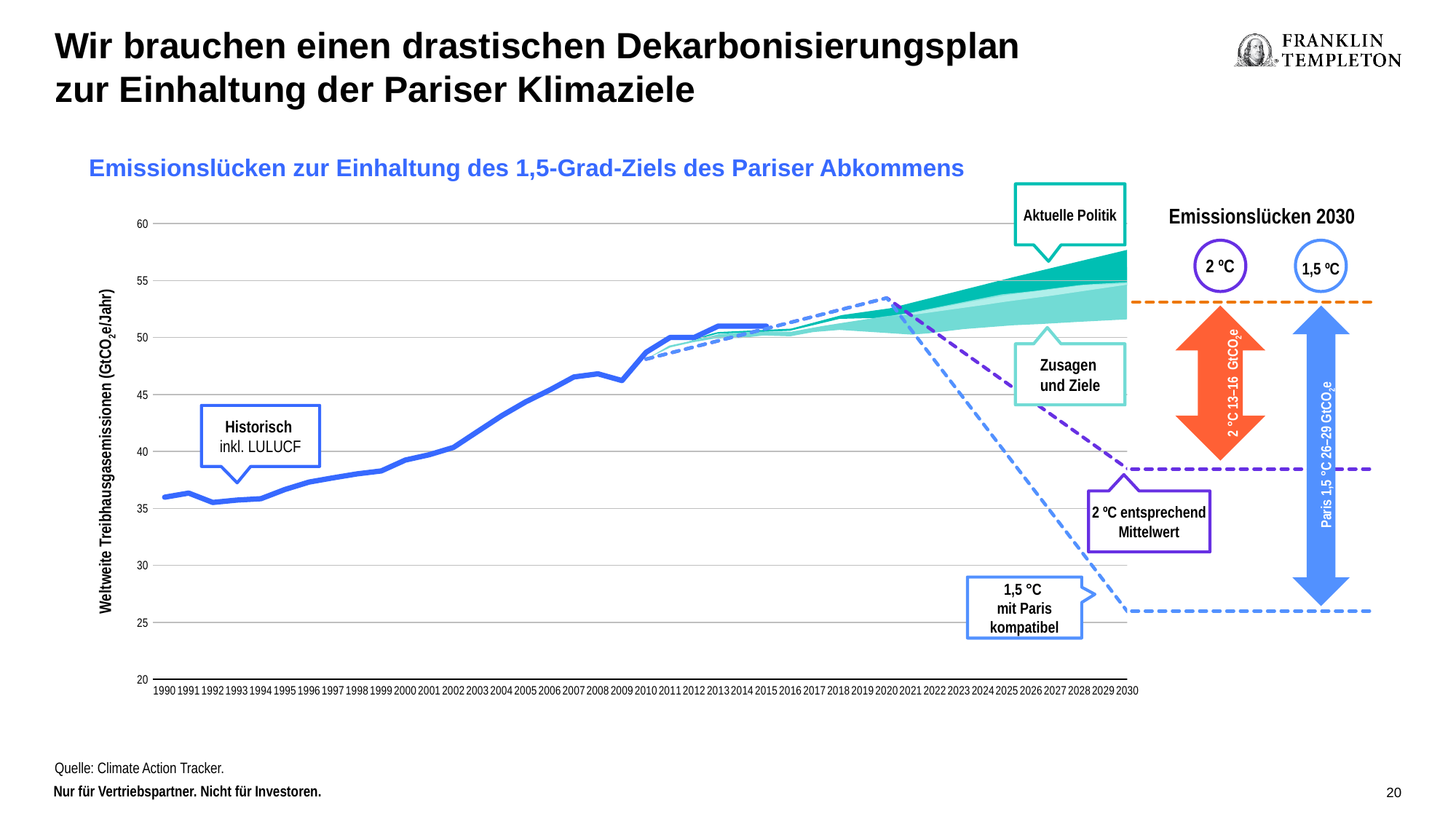
Which pathway is lower in 2030, '1,5 °C mit Paris kompatibel' or '2 °C entsprechend Mittelwert'? 1,5 °C mit Paris kompatibel Is the value of the '1,5 °C mit Paris kompatibel' pathway in 2030 greater or less than 30? less What kind of chart is shown on the slide? line chart What is the title of the chart? Emissionslücken zur Einhaltung des 1,5-Grad-Ziels des Pariser Abkommens What is the first year and the last year shown on the x axis? 1990 and 2030 Is the value of the '2 °C entsprechend Mittelwert' pathway in 2030 greater or less than 35? greater Do the historical emissions rise or fall between 1990 and 2019? rise Is the historical emissions value for 1990 greater or less than 40? less What is the emissions gap for 2030 shown for the Paris 1,5 °C target? 26–29 GtCO2e What is the label of the vertical axis? Weltweite Treibhausgasemissionen (GtCO2e/Jahr) What is the emissions gap for 2030 shown for the 2 °C target? 13–16 GtCO2e